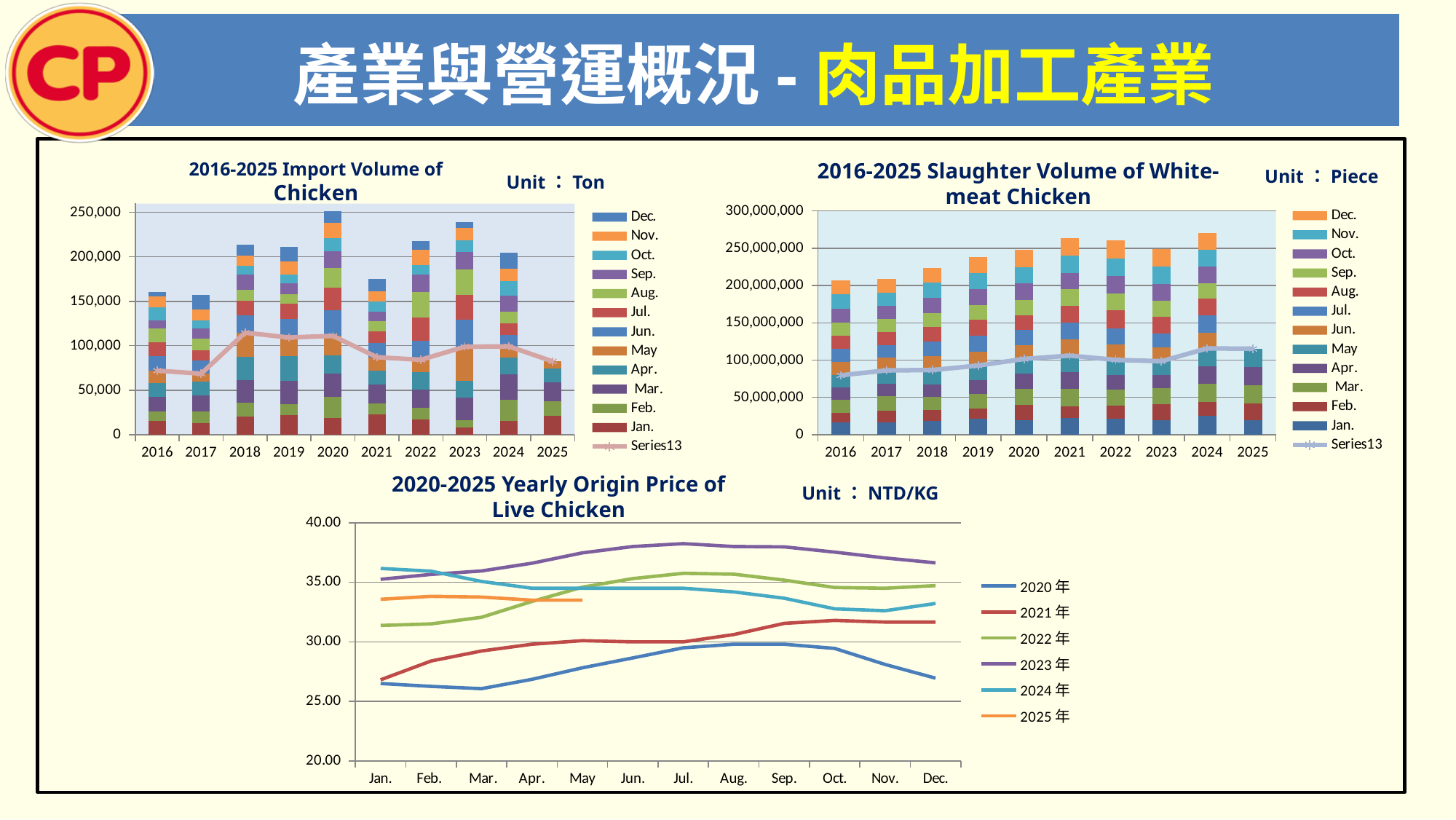
In the '2016-2025 Import Volume of Chicken' chart, which year has the lowest total import volume? 2025 In the '2016-2025 Import Volume of Chicken' chart, which year has the highest total import volume? 2020 What type of chart is the '2016-2025 Import Volume of Chicken' chart? stacked bar chart In the '2020-2025 Yearly Origin Price of Live Chicken' chart, which year's line is highest in Jul.? 2023 年 How many series does the legend of the '2020-2025 Yearly Origin Price of Live Chicken' chart list? 6 In the '2020-2025 Yearly Origin Price of Live Chicken' chart, is the 2020 年 value in Dec. greater or less than 30.00? less In the '2016-2025 Import Volume of Chicken' chart, is the total for 2025 greater or less than 100,000? less In the '2016-2025 Slaughter Volume of White-meat Chicken' chart, is the total for 2021 greater or less than 250,000,000? greater How many years are shown on the x axis of the '2016-2025 Import Volume of Chicken' chart? 10 In the '2016-2025 Slaughter Volume of White-meat Chicken' chart, which year has the highest total slaughter volume? 2024 What unit is stated for the '2016-2025 Slaughter Volume of White-meat Chicken' chart? Piece